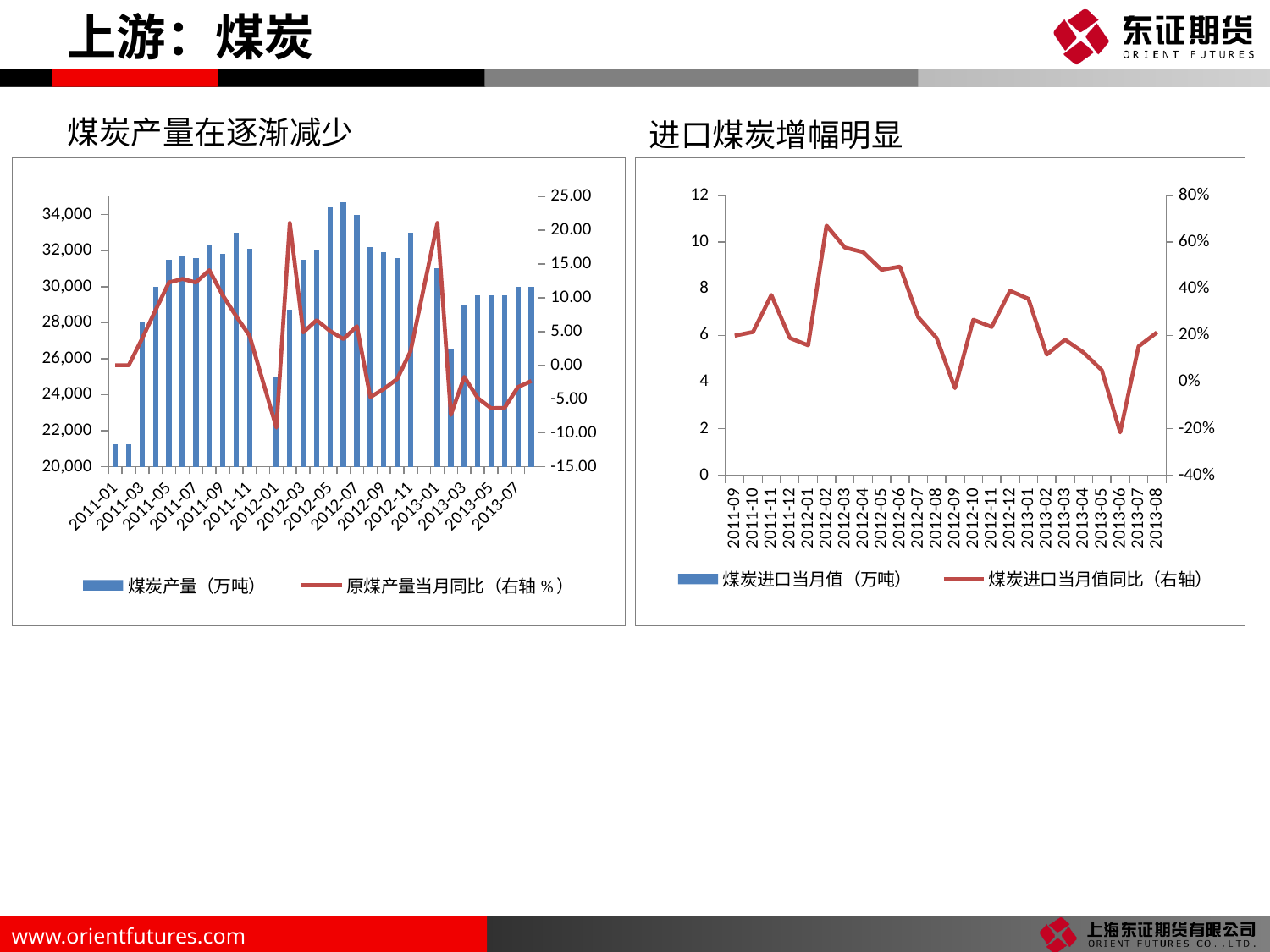
In the right chart (进口煤炭增幅明显), what is the name of the red line series? 煤炭进口当月值同比（右轴） How many series does the legend of the left chart (煤炭产量在逐渐减少) list? 2 In the left chart (煤炭产量在逐渐减少), is the 煤炭产量 bar for 2011-01 greater or less than 24,000? less What kind of chart is the right chart titled 进口煤炭增幅明显? bar chart with a line (combination bar and line chart) In the right chart (进口煤炭增幅明显), is the 煤炭进口当月值同比 value for 2013-06 greater or less than 0%? less In the right chart (进口煤炭增幅明显), in which month does the 煤炭进口当月值同比 line reach its lowest point? 2013-06 In the left chart (煤炭产量在逐渐减少), is the 原煤产量当月同比 value for 2012-01 greater or less than -5.00? less In the right chart (进口煤炭增幅明显), in which month does the 煤炭进口当月值同比 line reach its highest point? 2012-02 What kind of chart is the left chart titled 煤炭产量在逐渐减少? bar chart with a line In the left chart (煤炭产量在逐渐减少), which series is plotted on the right axis? 原煤产量当月同比（右轴 %） In the right chart (进口煤炭增幅明显), does the 煤炭进口当月值同比 line rise or fall from 2012-02 to 2012-09? fall How many series does the legend of the right chart (进口煤炭增幅明显) list? 2